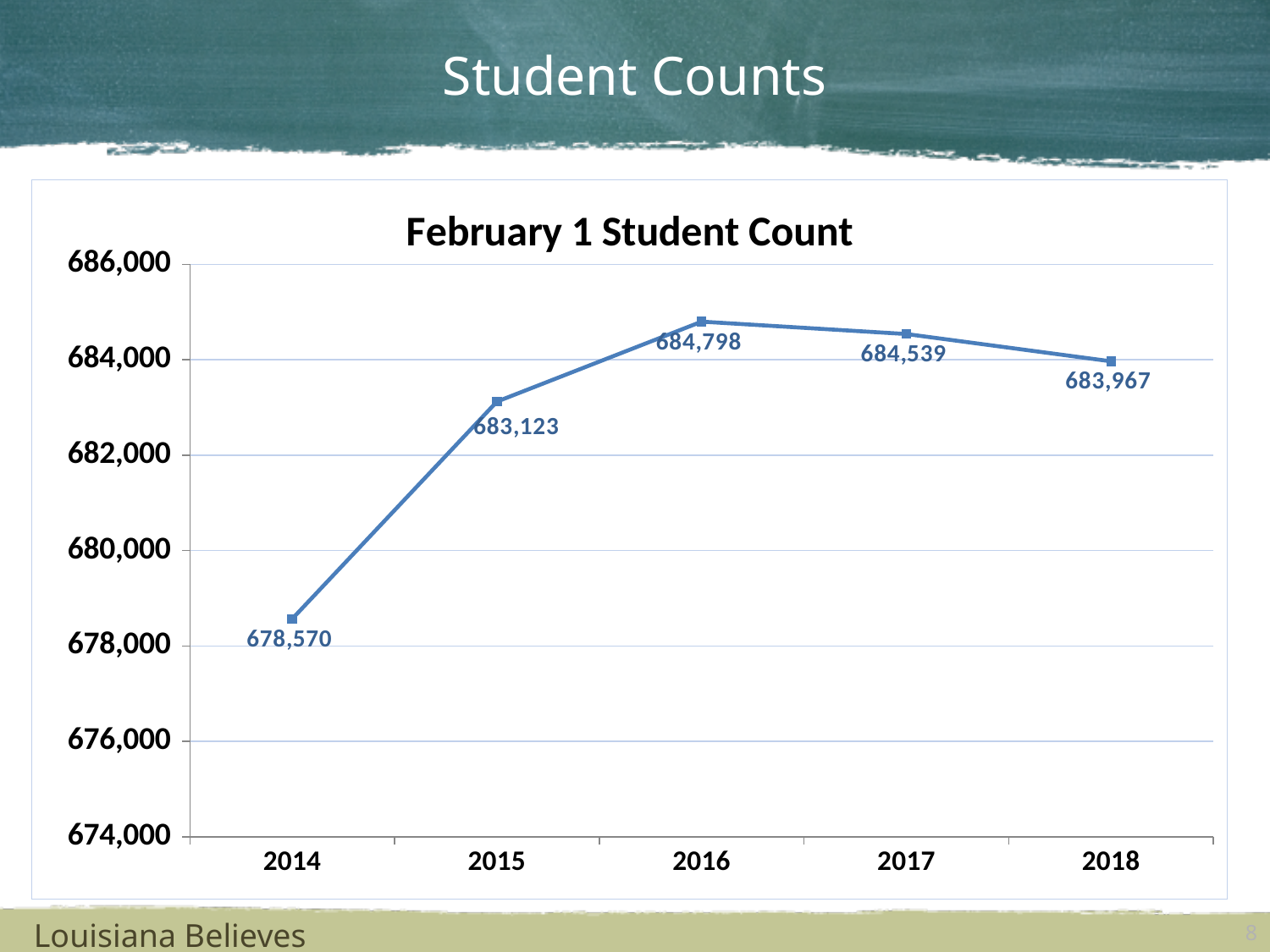
What is the February 1 student count for 2018? 683,967 How many years are plotted on the chart? 5 What is the February 1 student count for 2016? 684,798 Which year has the highest February 1 student count? 2016 Which year has a larger student count, 2017 or 2018? 2017 Is the student count for 2015 greater or less than 682,000? greater What is the difference between the student counts for 2015 and 2014? 4,553 Which year has the lowest February 1 student count? 2014 What is the title of the chart? February 1 Student Count What is the difference between the student counts for 2016 and 2018? 831 What kind of chart is shown on the slide? line chart What is the February 1 student count for 2014? 678,570